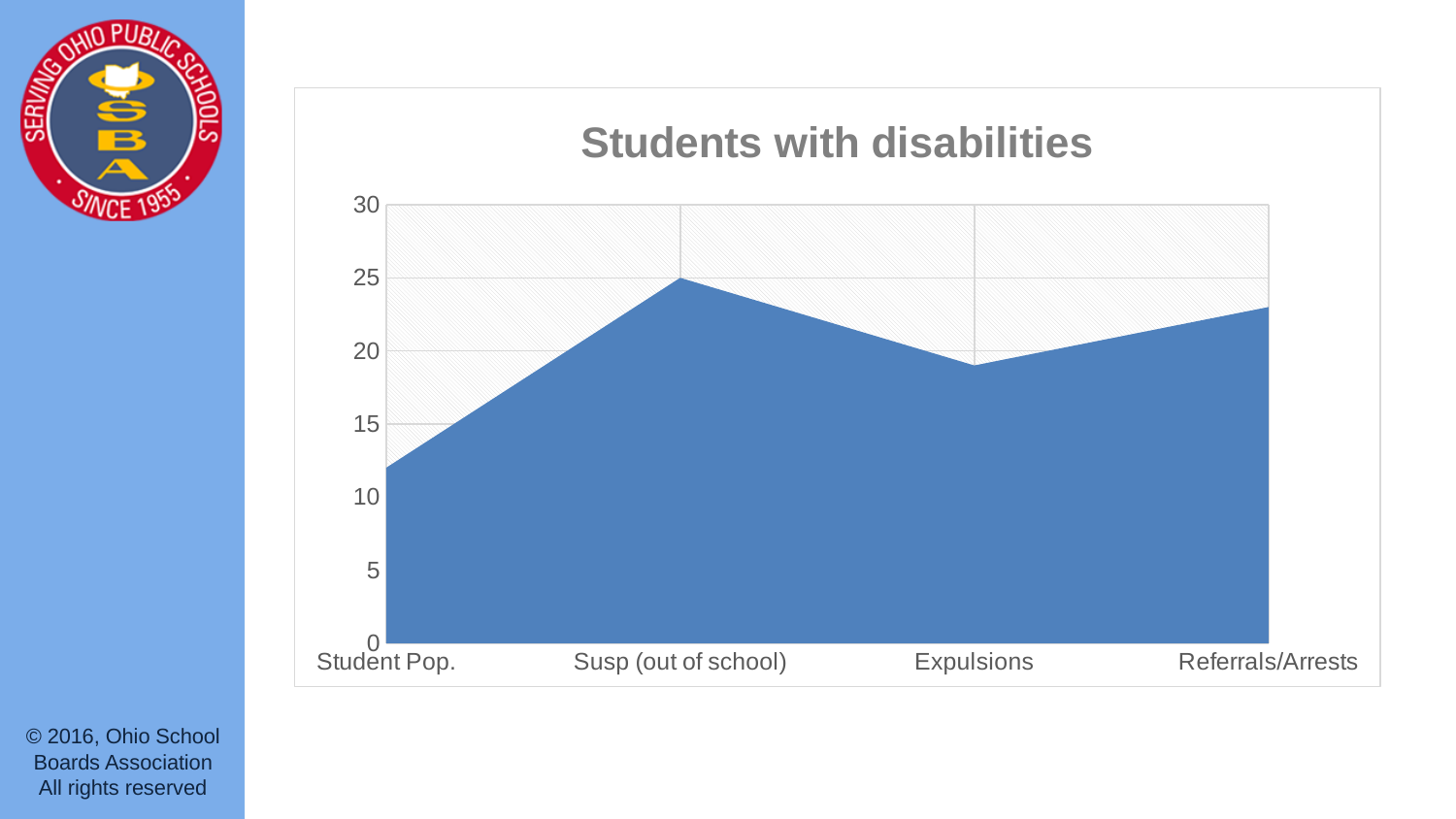
Does the value rise or fall from Susp (out of school) to Expulsions? fall Which category has the lowest value in the chart? Student Pop. Is the value for Susp (out of school) greater or less than 20? greater Which is larger, the value for Expulsions or the value for Referrals/Arrests? Referrals/Arrests Which category has the highest value in the chart? Susp (out of school) Is the value for Referrals/Arrests greater or less than 25? less How many categories are shown along the x axis of the chart? 4 What is the title of the chart? Students with disabilities What kind of chart is shown on the slide? area chart Which is larger, the value for Student Pop. or the value for Susp (out of school)? Susp (out of school) Is the value for Expulsions greater or less than 15? greater